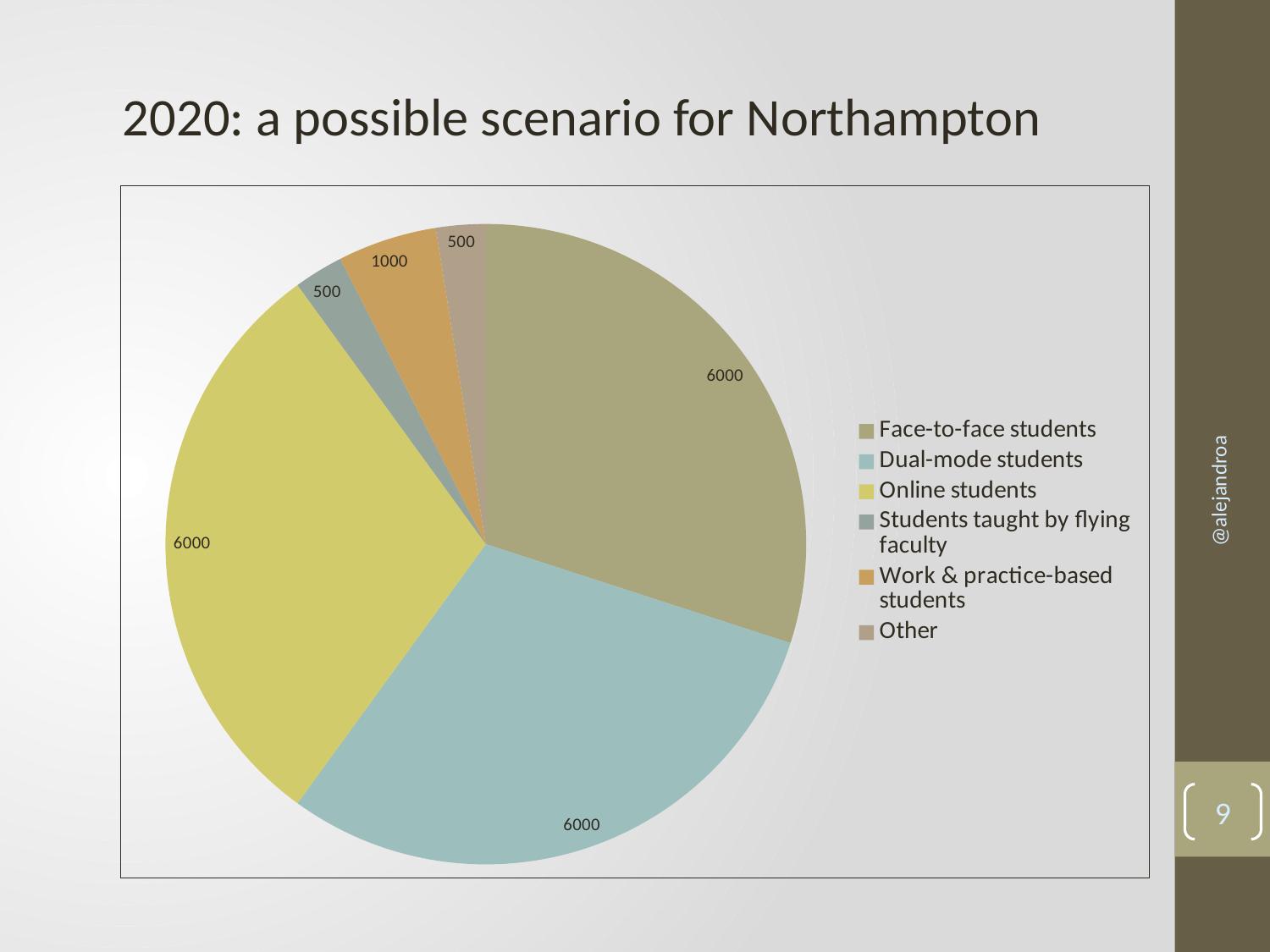
What value is shown for Online students? 6000 What value is shown for Other? 500 How many categories does the pie chart show? 6 What share of the pie does the Work & practice-based students slice represent? 5% Which is larger, the value for Work & practice-based students or the value for Other? Work & practice-based students What value is shown for Work & practice-based students? 1000 What value is shown for Students taught by flying faculty? 500 What value is shown for Face-to-face students? 6000 What kind of chart is shown on the slide? Pie chart What share of the pie does the Face-to-face students slice represent? 30% What is the difference between the value for Dual-mode students and the value for Work & practice-based students? 5000 What is the title of the slide containing the pie chart? 2020: a possible scenario for Northampton